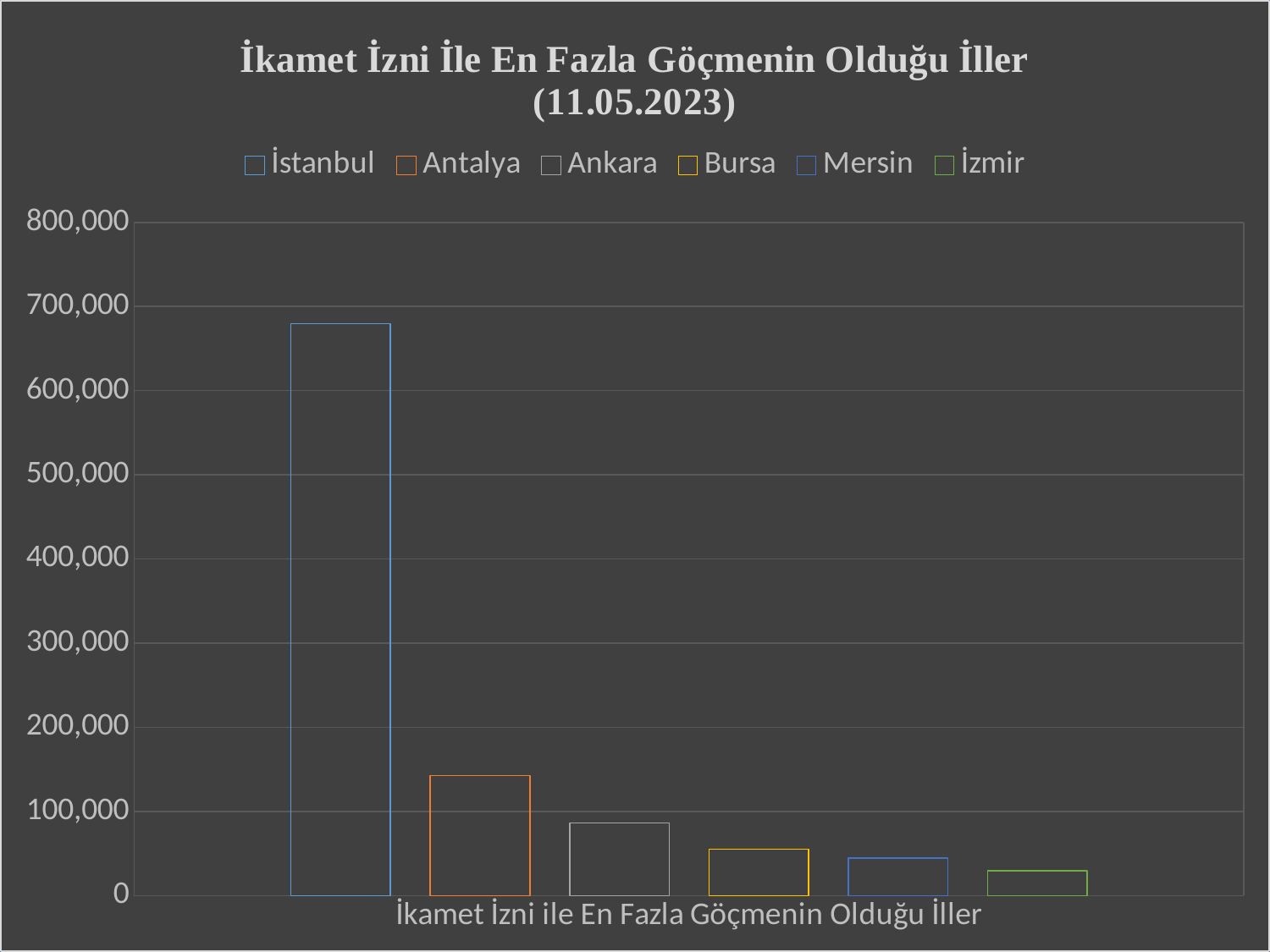
Which is larger, the value for Bursa or the value for Mersin? Bursa Which series has the highest value? İstanbul Do the bar values rise or fall from left to right across the chart? fall Which series has the lowest value? İzmir Is the value for Antalya greater or less than 200,000? less What is the title of the chart? İkamet İzni İle En Fazla Göçmenin Olduğu İller (11.05.2023) How many series does the legend list? 6 Is the value for İzmir greater or less than 100,000? less Is the value for İstanbul greater or less than 600,000? greater What kind of chart is shown on the slide? bar chart Which is larger, the value for Antalya or the value for Ankara? Antalya